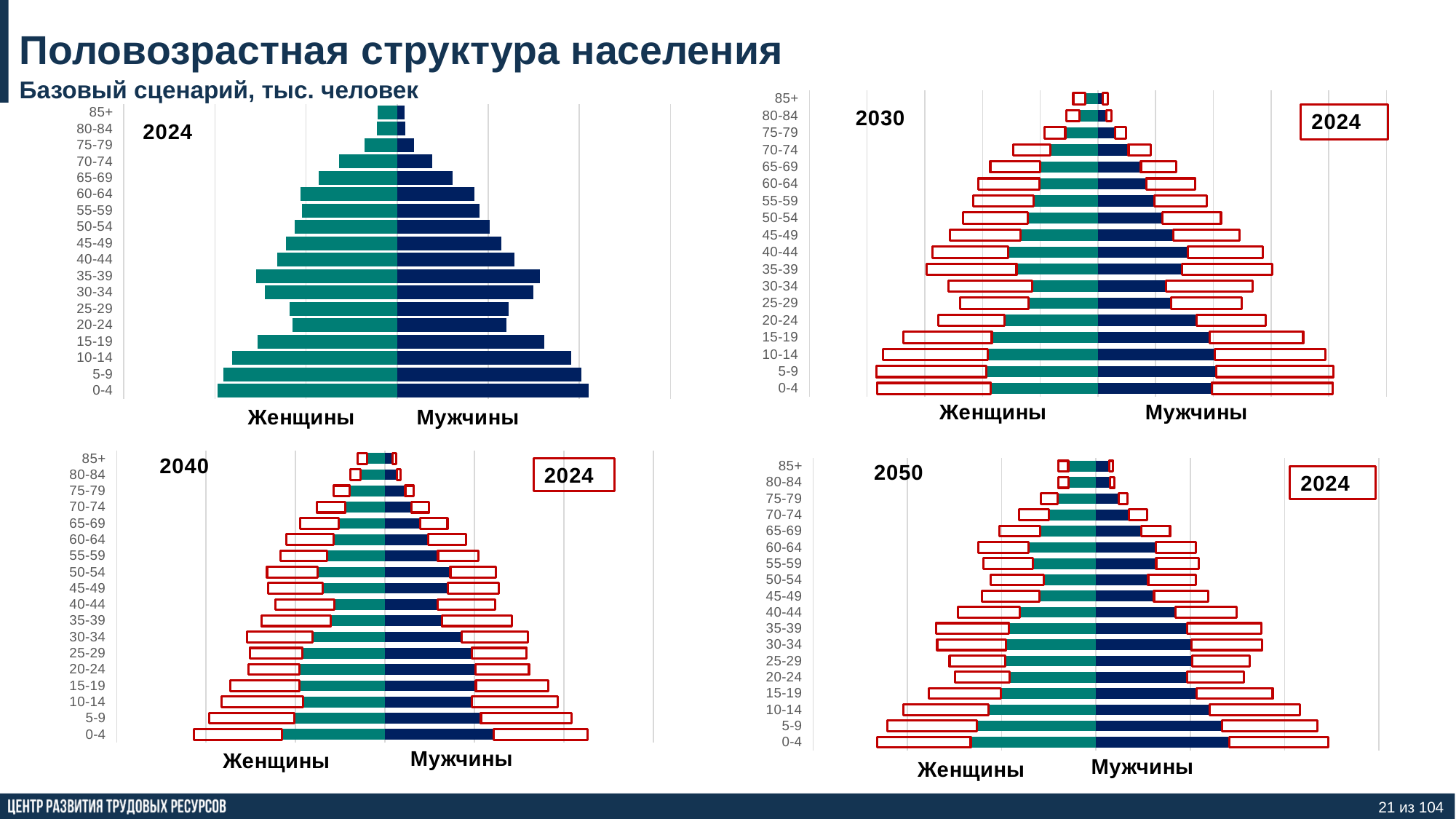
In the 2050 chart, which is larger for men: the 0-4 group or the 60-64 group? 0-4 In the 2024 chart, which is larger for women: the 10-14 group or the 25-29 group? 10-14 What kind of chart is used on this slide to show the population structure? Bar chart (population pyramid) In the 2030 chart, which age group has the shortest bars? 85+ What are the two series labelled in the 2024 chart? Женщины and Мужчины What year do the red outlined bars in the 2030, 2040 and 2050 charts represent? 2024 In the 2040 chart, which age group has the longest bars? 0-4 How many series does each chart show? The 2024 chart shows 2 series; the 2030, 2040 and 2050 charts each show 4 (filled bars for that year plus red-outlined 2024 bars for men and women) How many charts are shown on the slide? 4 In the 2024 chart, do the bars generally get shorter or longer moving from the 0-4 group up to the 85+ group? Shorter How many age groups are listed on the vertical axis of the 2024 chart? 18 In the 2024 chart, which is larger for men: the 35-39 group or the 20-24 group? 35-39